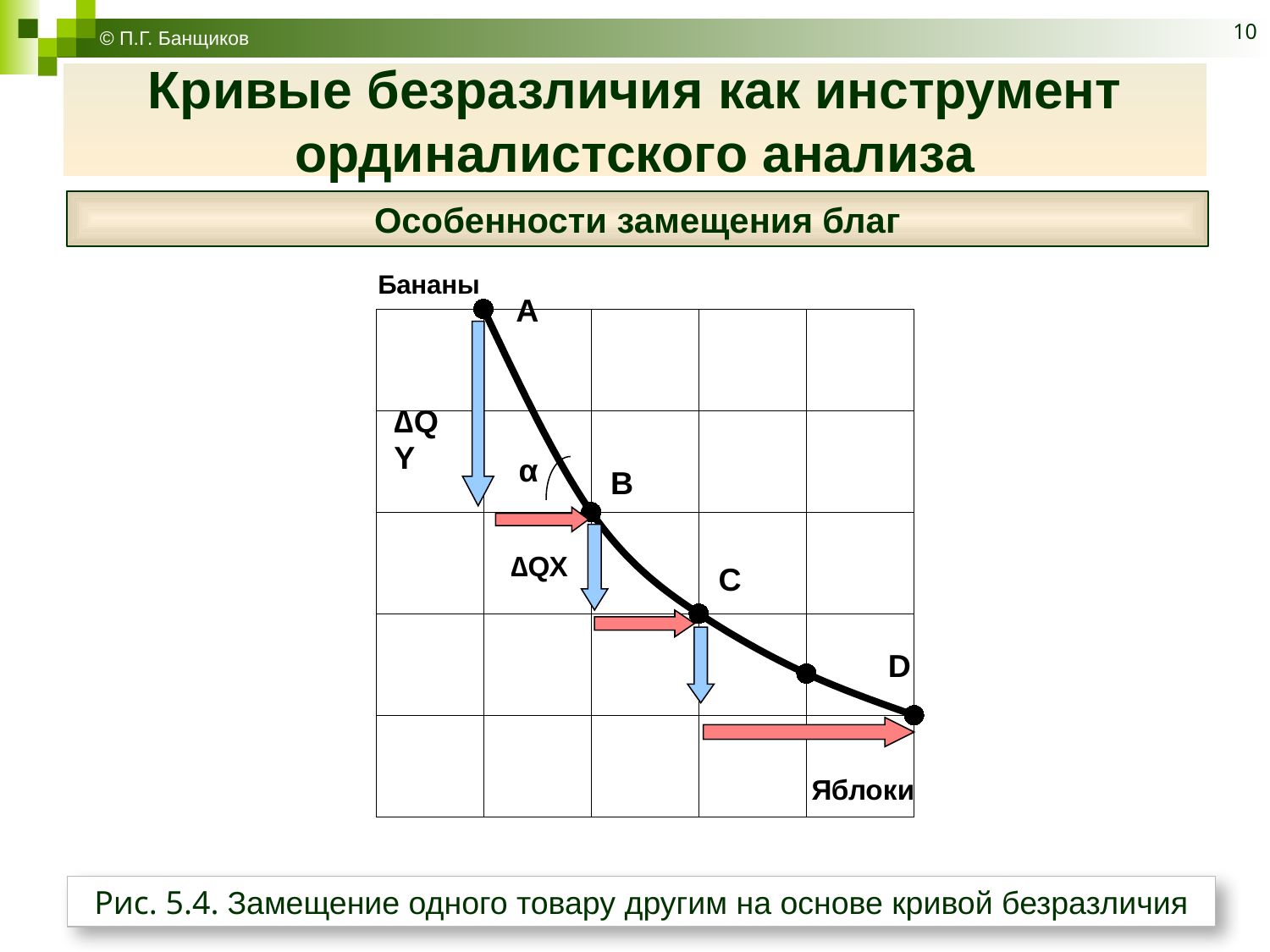
Which labeled point on the curve has the lowest value on the vertical axis? D Which point has more bananas (higher vertical value), A or C? A Does the curve rise or fall as you move from left to right along the x axis? fall Which point has more apples (larger horizontal value), B or D? D What is the label of the vertical axis of the chart? Бананы What kind of chart is shown on the slide? line chart Which labeled point lies furthest to the left along the horizontal axis? A What is the label of the horizontal axis of the chart? Яблоки Which labeled point on the curve has the highest value on the vertical axis? A Which labeled point lies furthest to the right along the horizontal axis? D How many labeled points (A, B, C, D) are marked on the curve? 4